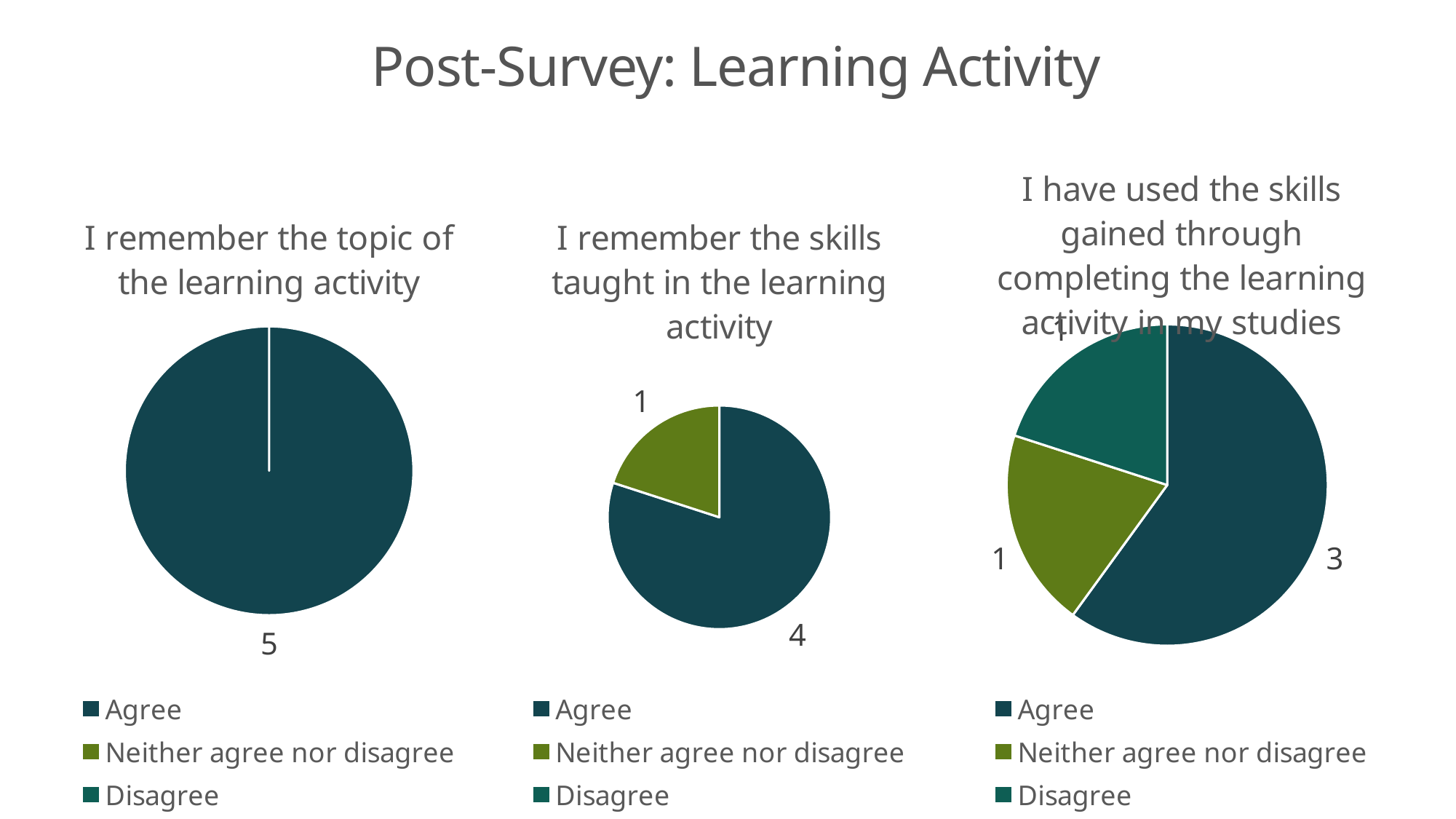
In the right-hand chart, what share of the pie does the Agree slice represent? 60% In the chart titled "I have used the skills gained through completing the learning activity in my studies", what value is shown for Disagree? 1 How many entries does the legend of the left-hand chart list? 3 In the chart titled "I remember the skills taught in the learning activity", what value is shown for Agree? 4 In the middle chart, what share of the pie does the Agree slice represent? 80% What type of chart is used on this slide? Pie chart In the right-hand chart, which response category has the largest slice? Agree In the middle chart, what is the difference between the Agree value and the Neither agree nor disagree value? 3 In the chart titled "I have used the skills gained through completing the learning activity in my studies", what value is shown for Agree? 3 In the chart titled "I remember the topic of the learning activity", what value is shown for Agree? 5 In the right-hand chart, which is larger: the Agree value or the Neither agree nor disagree value? Agree In the chart titled "I remember the skills taught in the learning activity", what value is shown for Neither agree nor disagree? 1